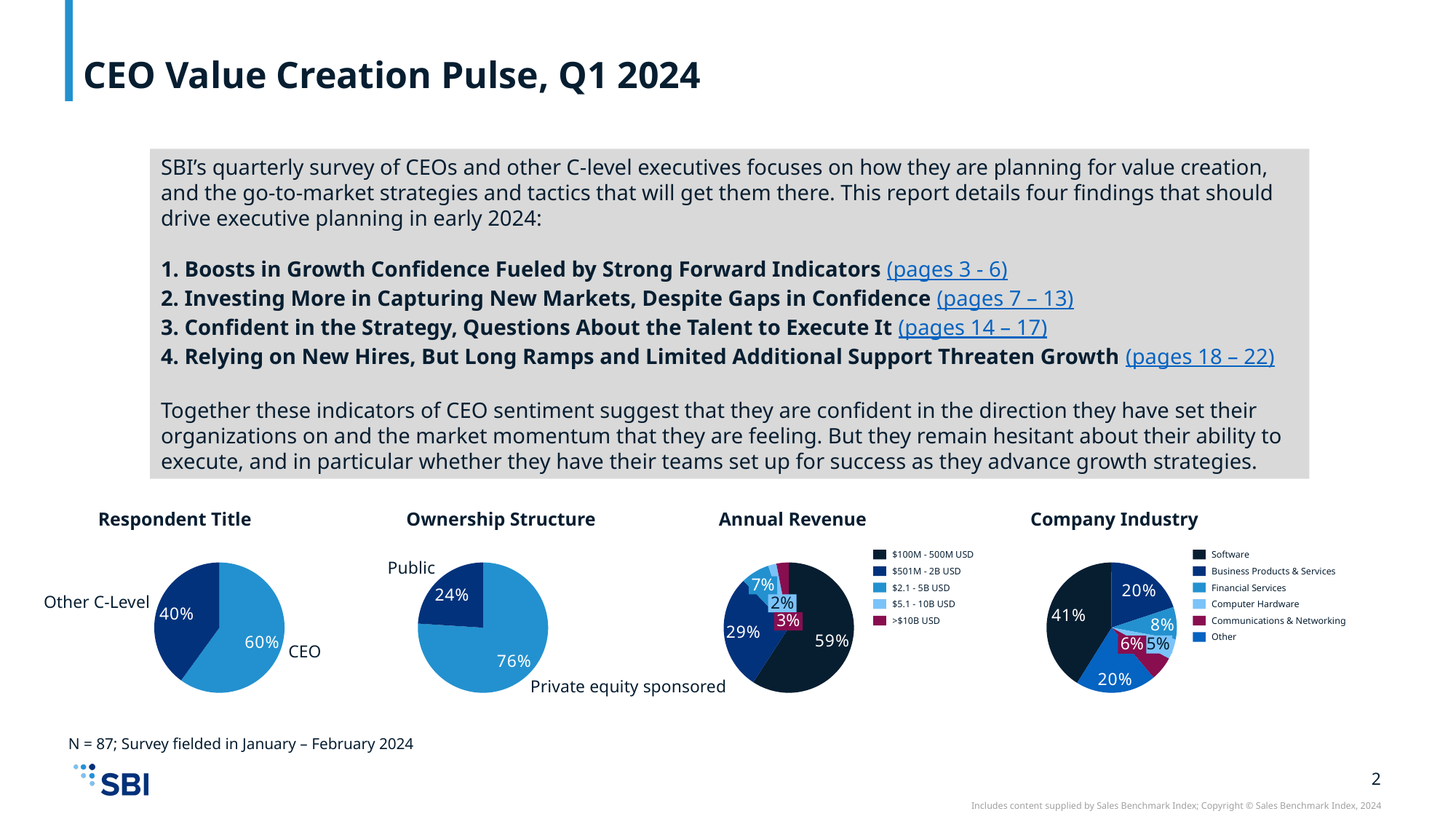
In the Ownership Structure chart, what is the difference between the Private equity sponsored and Public shares? 52 percentage points In the Annual Revenue chart, which revenue band has the smallest share? $5.1 - 10B USD How many charts are shown on the slide? 4 In the Company Industry chart, which industry has the largest share? Software In the Annual Revenue chart, how many revenue bands does the legend list? 5 What type of chart is the Ownership Structure chart? Pie chart In the Annual Revenue chart, what share of companies have revenue of $100M - 500M USD? 59% In the Company Industry chart, which is larger, Communications & Networking or Computer Hardware? Communications & Networking In the Respondent Title chart, what share of respondents are CEOs? 60% In the Respondent Title chart, what share of respondents are Other C-Level? 40% In the Company Industry chart, what share of companies are in Financial Services? 8% In the Ownership Structure chart, what share of companies are Private equity sponsored? 76%